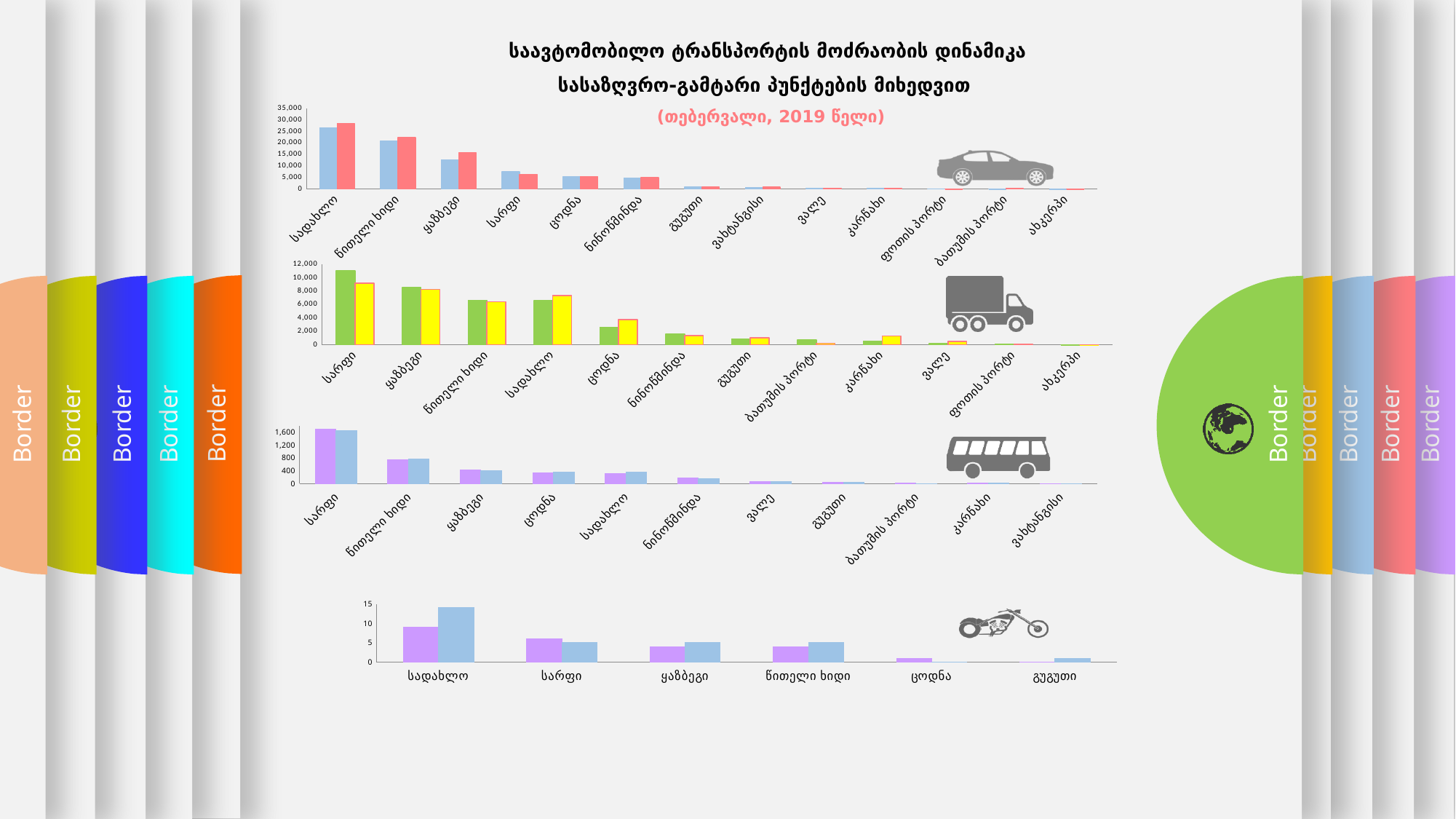
What kind of chart is the top chart with the car icon? bar chart In the second chart with the truck icon, is the value of the green bar for სარფი greater or less than 10,000? greater In the bottom chart with the motorcycle icon, is the value of the blue bar for სადახლო greater or less than 10? greater In the second chart with the truck icon, for ცოდნა, which bar is taller, the green one or the yellow one? yellow What period is given in the subtitle below the chart title? თებერვალი, 2019 წელი In the top chart with the car icon, is the value of the red bar for სადახლო greater or less than 25,000? greater In the top chart with the car icon, which category has the tallest bars? სადახლო How many categories are shown on the x axis of the bottom chart with the motorcycle icon? 6 How many categories are shown on the x axis of the top chart with the car icon? 13 In the second chart with the truck icon, which category has the tallest green bar? სარფი